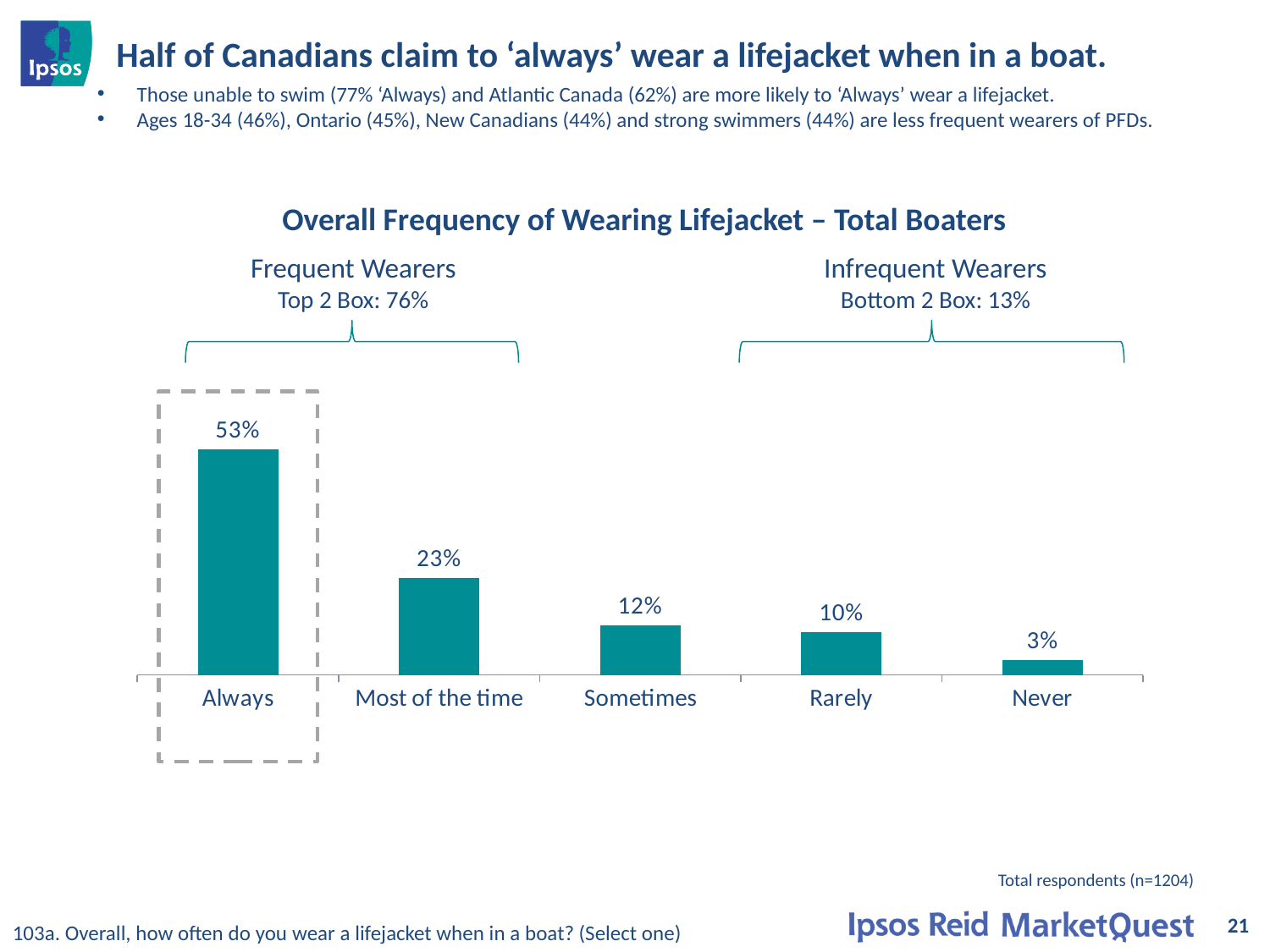
How many categories are shown on the x axis? 5 What percentage of boaters say they 'Always' wear a lifejacket? 53% Which category has the lowest value? Never What is the difference between the 'Always' and 'Most of the time' values? 30% What is the value for 'Never'? 3% What kind of chart is shown? Bar chart Which is larger, the value for 'Rarely' or the value for 'Never'? Rarely Do the values rise or fall moving from 'Always' to 'Never' along the x axis? Fall Which category has the highest value? Always What is the value for 'Most of the time'? 23% What is the difference between the 'Sometimes' and 'Rarely' values? 2% What is the title of the chart? Overall Frequency of Wearing Lifejacket – Total Boaters